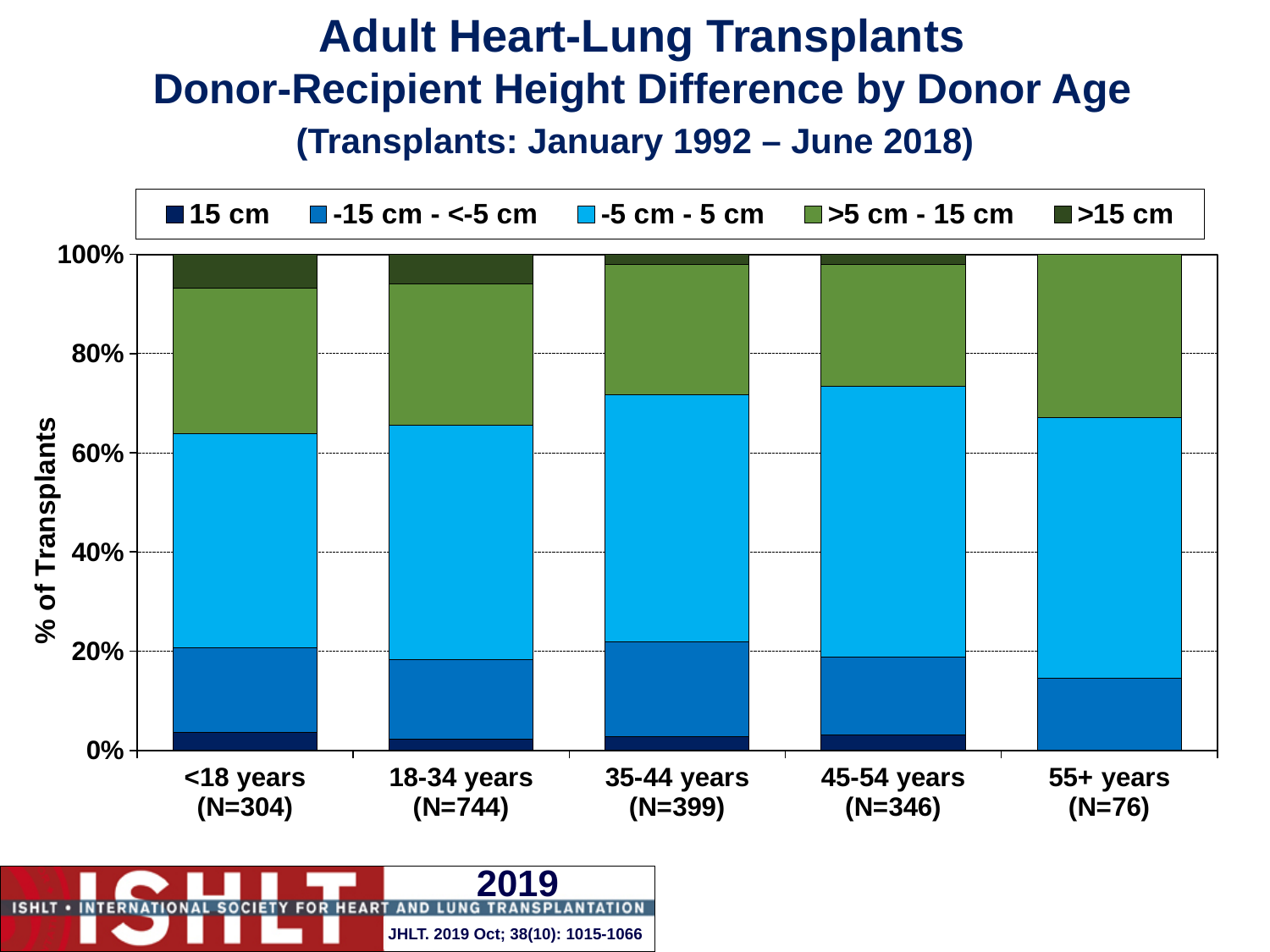
Is the '>5 cm - 15 cm' segment for the <18 years group greater or less than 20%? greater Which donor age group has the smallest '>15 cm' segment? 55+ years Is the '-15 cm - <-5 cm' segment larger for the 35-44 years group or the 55+ years group? 35-44 years What is the N value shown for the 55+ years donor age group? N=76 What is the total of the stacked bar for the 45-54 years group? 100% How many series does the legend list? 5 Is the '-5 cm - 5 cm' segment for the 55+ years group greater or less than 40%? greater What is the N value shown for the 18-34 years donor age group? N=744 What is the label of the y axis? % of Transplants What kind of chart is shown on the slide? Stacked bar chart How many donor age categories are shown on the x axis? 5 Is the '-15 cm - <-5 cm' segment for the 55+ years group greater or less than 20%? less